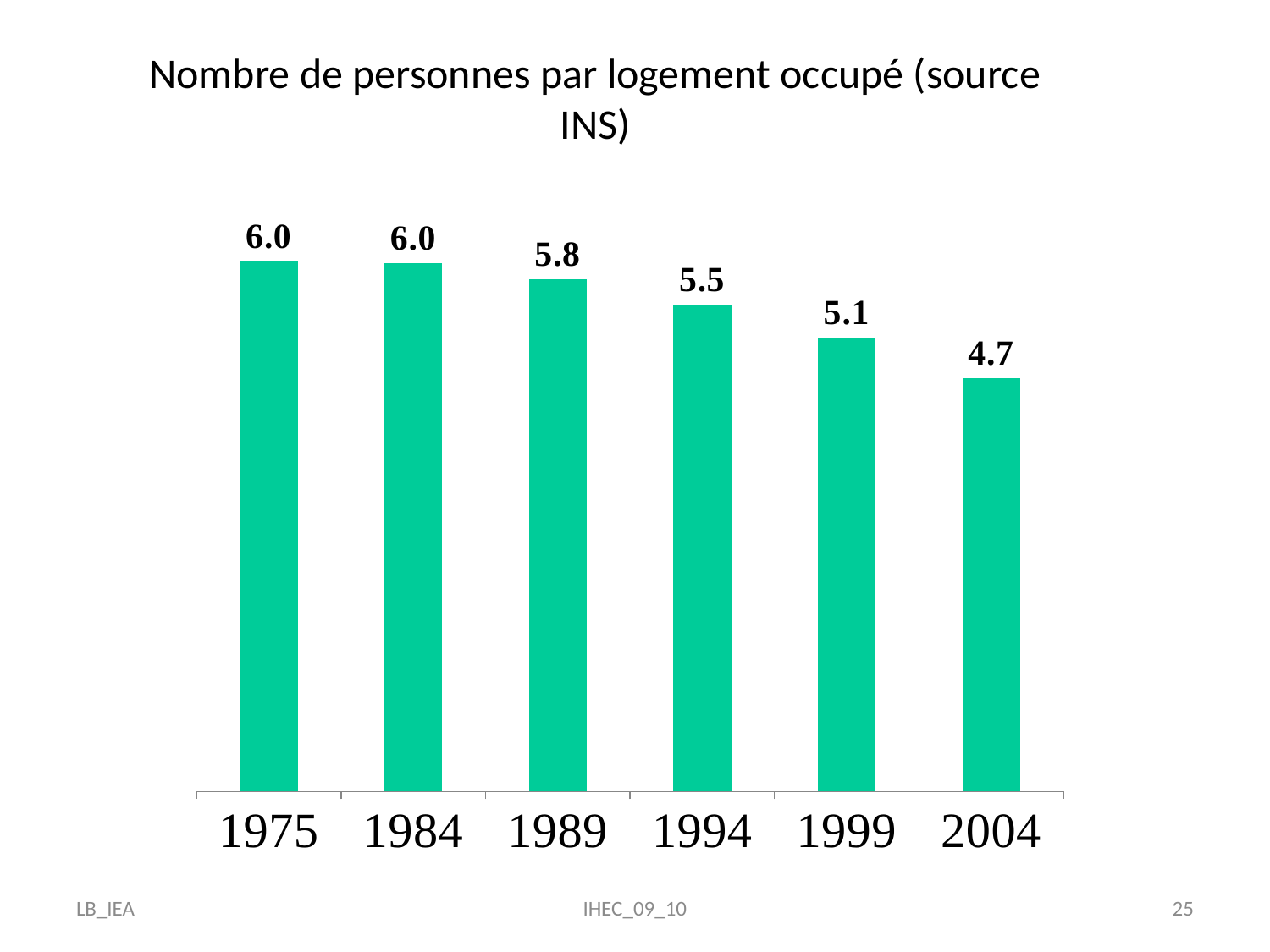
What is the difference between the values for 1989 and 1994? 0.3 What kind of chart is shown on the slide? Bar chart What is the value shown for 1999? 5.1 Do the values rise or fall from 1975 to 2004? Fall What is the title of the chart? Nombre de personnes par logement occupé (source INS) Which year has the lowest value? 2004 What is the difference between the values for 1975 and 2004? 1.3 What is the number of persons per occupied dwelling in 1975? 6.0 Which is larger, the value for 1989 or the value for 1999? 1989 What is the value shown for 2004? 4.7 How many years are shown on the x axis? 6 What is the value shown for 1994? 5.5